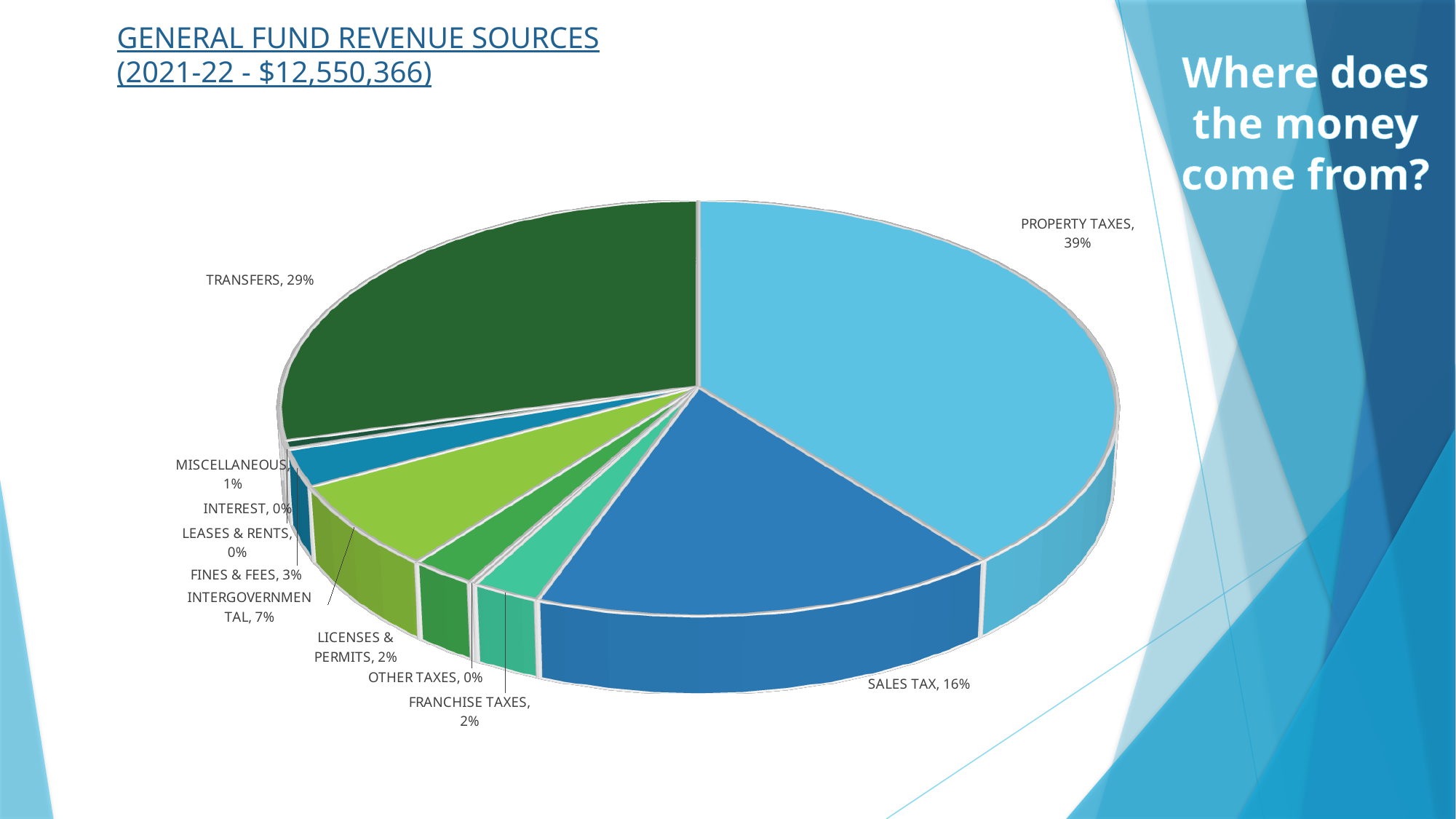
What is the difference in percentage points between PROPERTY TAXES and SALES TAX? 23 Which revenue source has the largest share of the pie? PROPERTY TAXES What share of general fund revenue comes from SALES TAX? 16% What share of general fund revenue comes from TRANSFERS? 29% Which is larger, the share for SALES TAX or the share for TRANSFERS? TRANSFERS What kind of chart is shown on the slide? Pie chart How many revenue source categories are labelled on the pie chart? 11 What share of general fund revenue comes from INTERGOVERNMENTAL? 7% What is the total general fund revenue amount shown in the chart title? $12,550,366